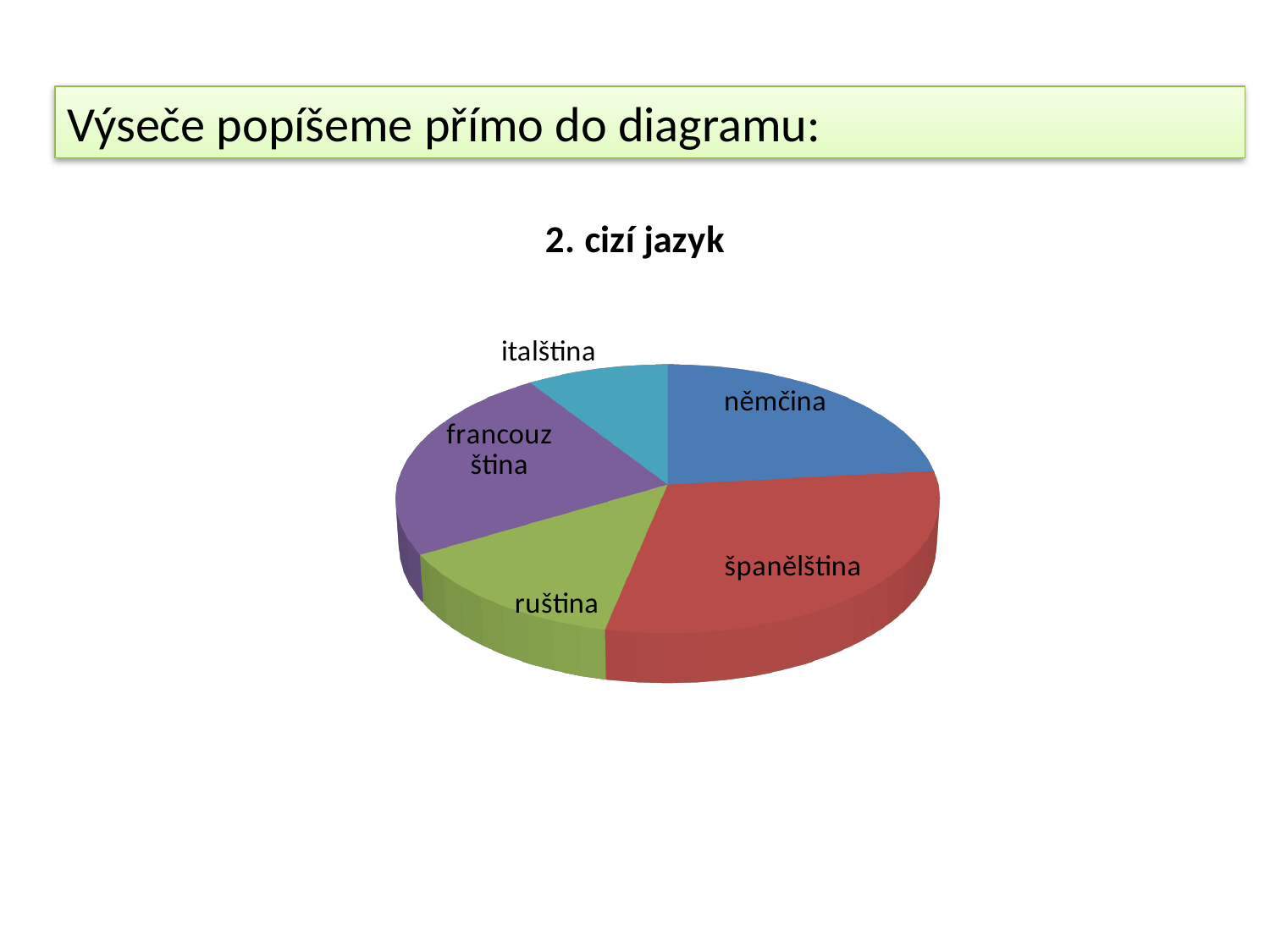
Which language has the smallest slice of the pie? italština What is the title of the chart? 2. cizí jazyk Which slice is larger, francouzština or italština? francouzština Which slice is larger, italština or španělština? španělština What kind of chart is shown on the slide? pie chart How many slices does the pie chart have? 5 Which language has the largest slice of the pie? španělština Which slice is larger, španělština or němčina? španělština What colour is the slice for němčina? blue